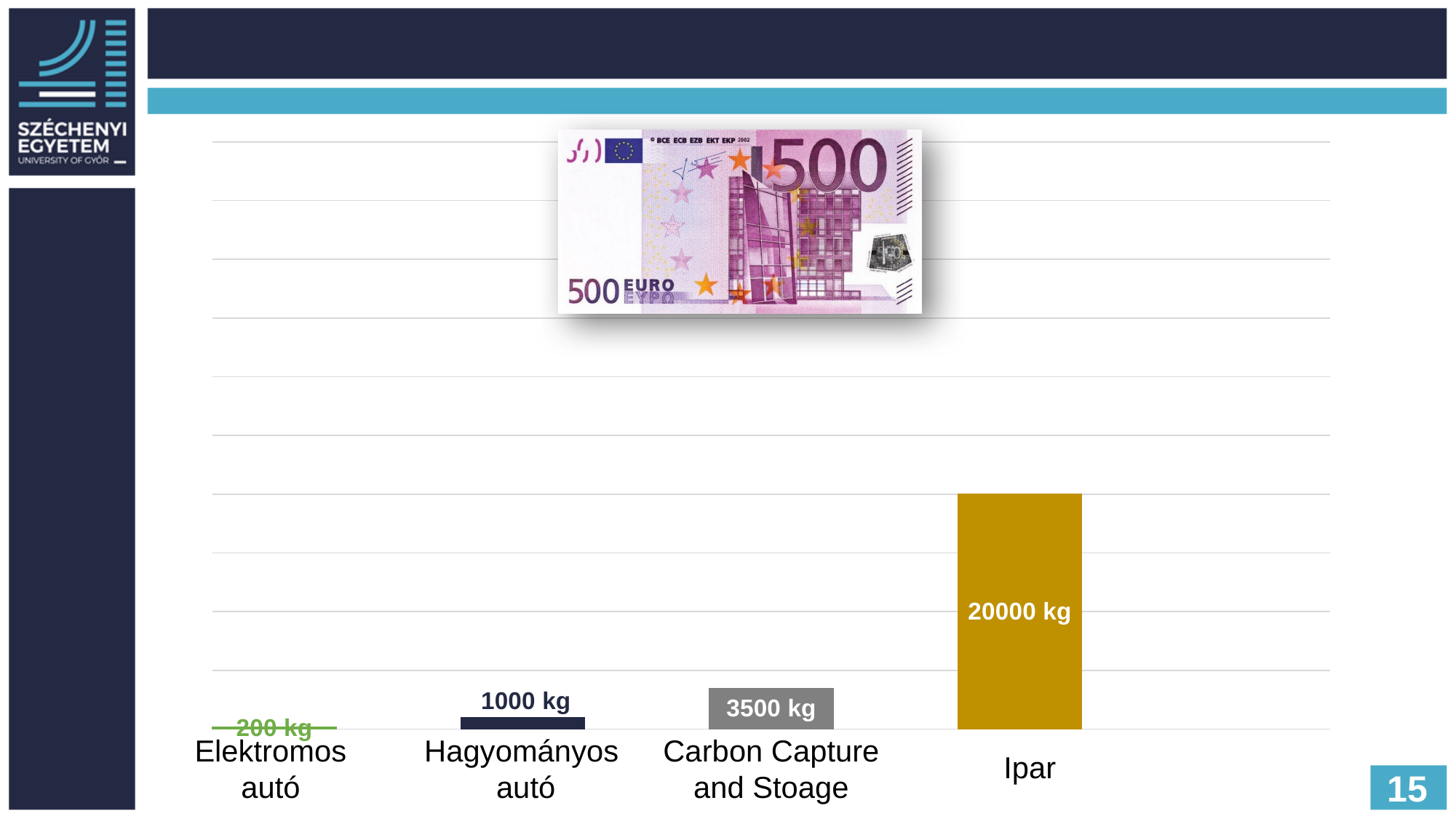
What kind of chart is shown on the slide? Bar chart Which category has the lowest value? Elektromos autó Which is larger, the value for Carbon Capture and Stoage or the value for Hagyományos autó? Carbon Capture and Stoage How many categories are shown on the x axis? 4 What value is shown for Elektromos autó? 200 kg Which category has the highest value? Ipar What value is shown for Ipar? 20000 kg What value is shown for Carbon Capture and Stoage? 3500 kg What is the difference between the values for Ipar and Carbon Capture and Stoage? 16500 kg What is the difference between the values for Hagyományos autó and Elektromos autó? 800 kg What image is placed above the chart? A 500 euro banknote What value is shown for Hagyományos autó? 1000 kg